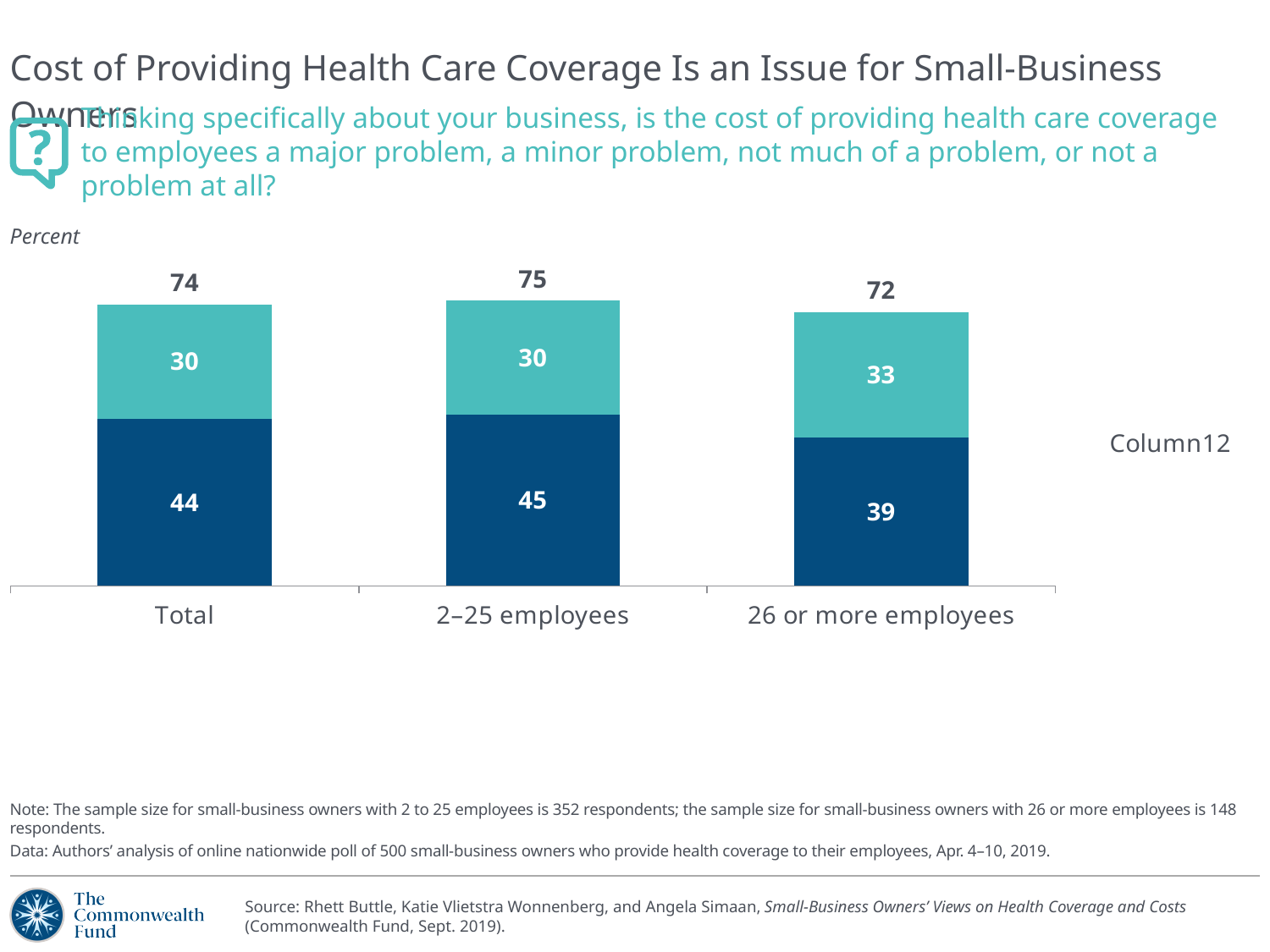
How many categories are shown on the x axis? 3 What is the difference between the stacked bar totals for Total and 26 or more employees? 2 What is the value of the teal (upper) segment for the 2–25 employees bar? 30 What is the value of the dark blue segment for the Total bar? 44 What is the difference between the dark blue segment values for 2–25 employees and 26 or more employees? 6 What is the total of the stacked bar for 2–25 employees? 75 What kind of chart is shown on the slide? Stacked bar chart What is the value of the teal (upper) segment for the 26 or more employees bar? 33 Which category has the lowest stacked bar total? 26 or more employees What unit label appears above the chart? Percent Which category has the highest stacked bar total? 2–25 employees Is the teal (upper) segment larger for Total or for 26 or more employees? 26 or more employees